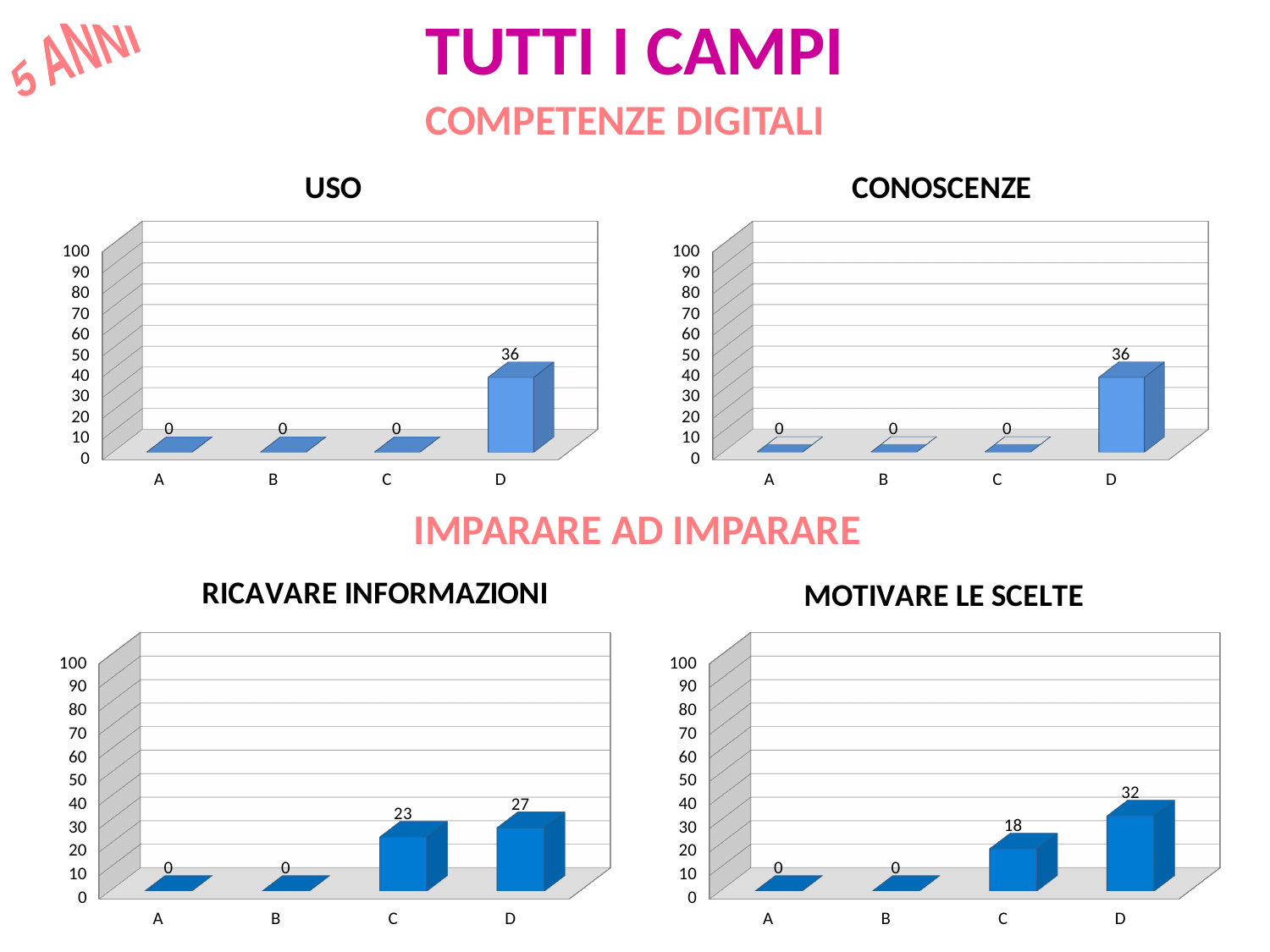
In the RICAVARE INFORMAZIONI chart, which is larger, the value for C or the value for D? D In the RICAVARE INFORMAZIONI chart, what is the value for C? 23 In the MOTIVARE LE SCELTE chart, what is the difference between the values for D and C? 14 In the USO chart, what is the value for D? 36 How many categories are shown in the CONOSCENZE chart? 4 In the USO chart, is the value for D greater or less than 50? less In the MOTIVARE LE SCELTE chart, which category has the highest value? D In the RICAVARE INFORMAZIONI chart, what is the difference between the values for D and C? 4 In the CONOSCENZE chart, what is the value for D? 36 In the USO chart, what is the value for A? 0 What kind of chart is the RICAVARE INFORMAZIONI chart? bar chart In the MOTIVARE LE SCELTE chart, what is the value for D? 32